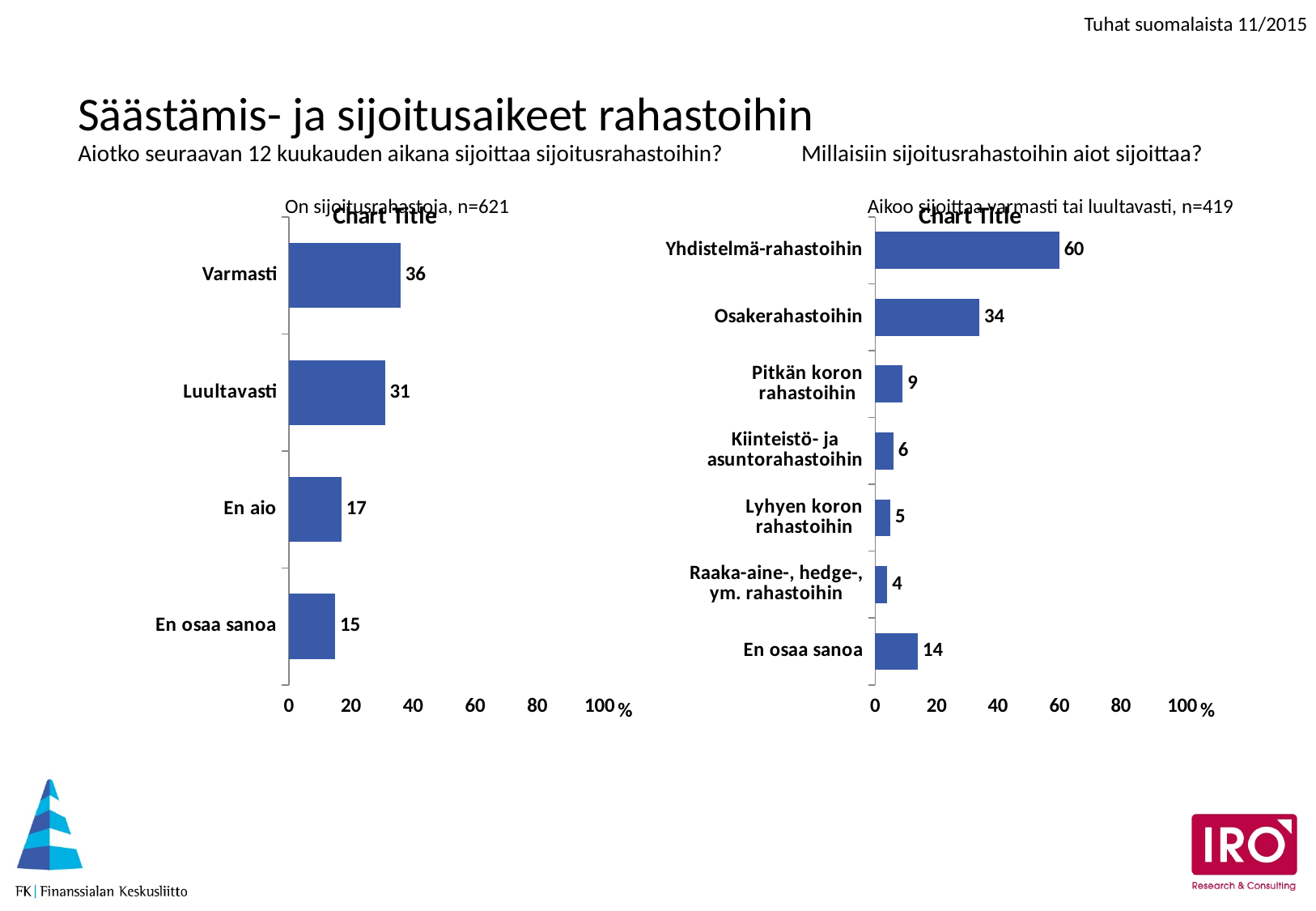
In the right chart, which is larger: Osakerahastoihin or En osaa sanoa? Osakerahastoihin In the right chart, what is the value for Kiinteistö- ja asuntorahastoihin? 6 In the left chart, how many categories are shown? 4 In the right chart, which category has the lowest value? Raaka-aine-, hedge-, ym. rahastoihin What type of chart is the right chart? Bar chart In the left chart, what is the difference between Varmasti and Luultavasti? 5 In the left chart, what is the value for Varmasti? 36 In the left chart, what is the value for En aio? 17 In the right chart, which category has the highest value? Yhdistelmä-rahastoihin In the right chart, what is the value for Yhdistelmä-rahastoihin? 60 In the left chart, which category has the lowest value? En osaa sanoa In the right chart, what is the difference between Yhdistelmä-rahastoihin and Osakerahastoihin? 26